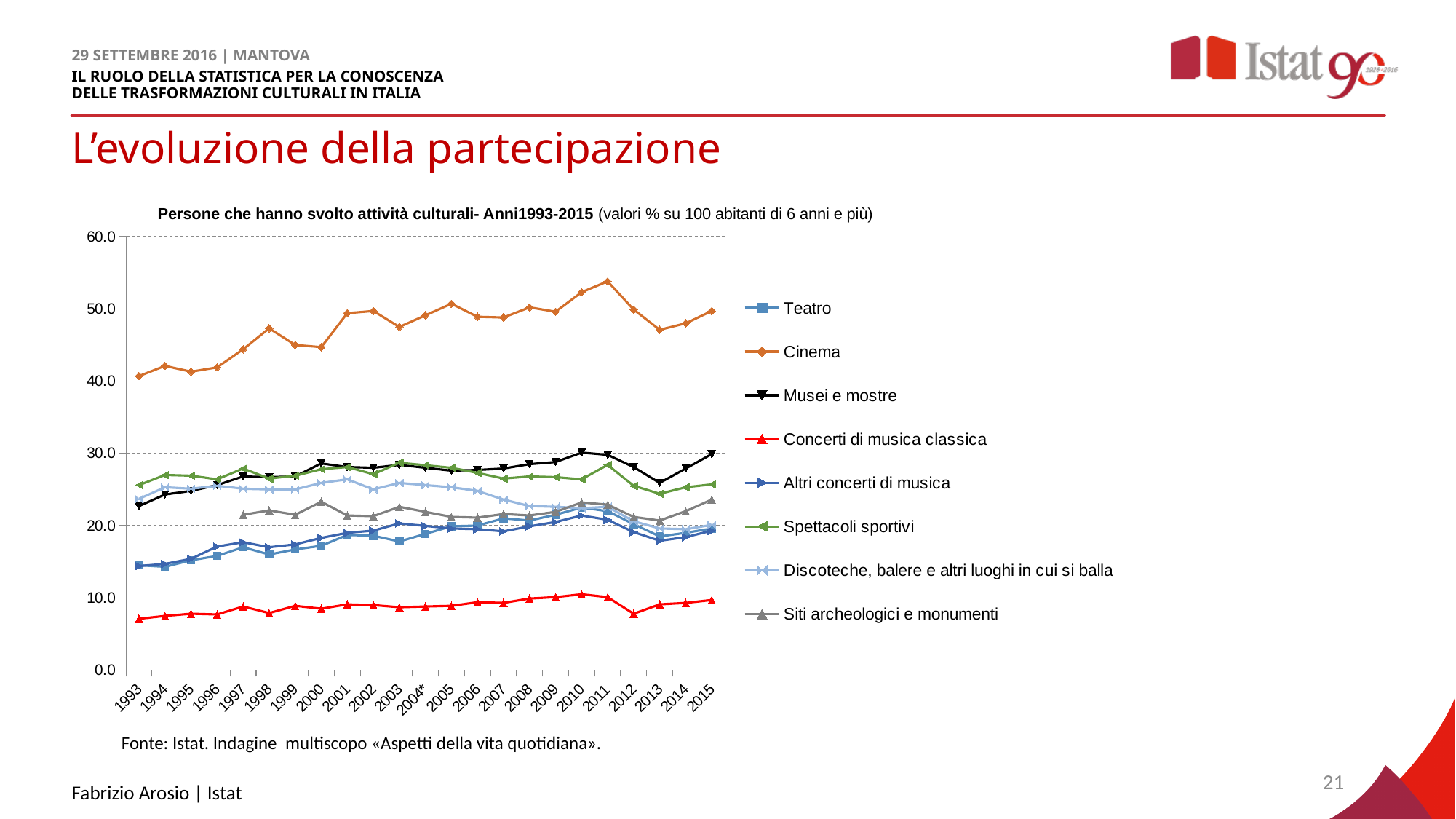
What kind of chart is shown on the slide? line chart What is the title of the chart? Persone che hanno svolto attività culturali- Anni1993-2015 (valori % su 100 abitanti di 6 anni e più) Is the value for Musei e mostre in 2013 greater or less than 30.0? less Is the value for Cinema in 1993 greater or less than 50.0? less Which series has the lowest values across the whole period? Concerti di musica classica Which series has the highest values across the whole period? Cinema How many years are shown along the x axis? 23 In 2015, which is larger: Cinema or Musei e mostre? Cinema How many series does the legend list? 8 Does the Cinema series overall rise or fall from 1993 to 2015? rise Is the value for Teatro in 1993 greater or less than 20.0? less